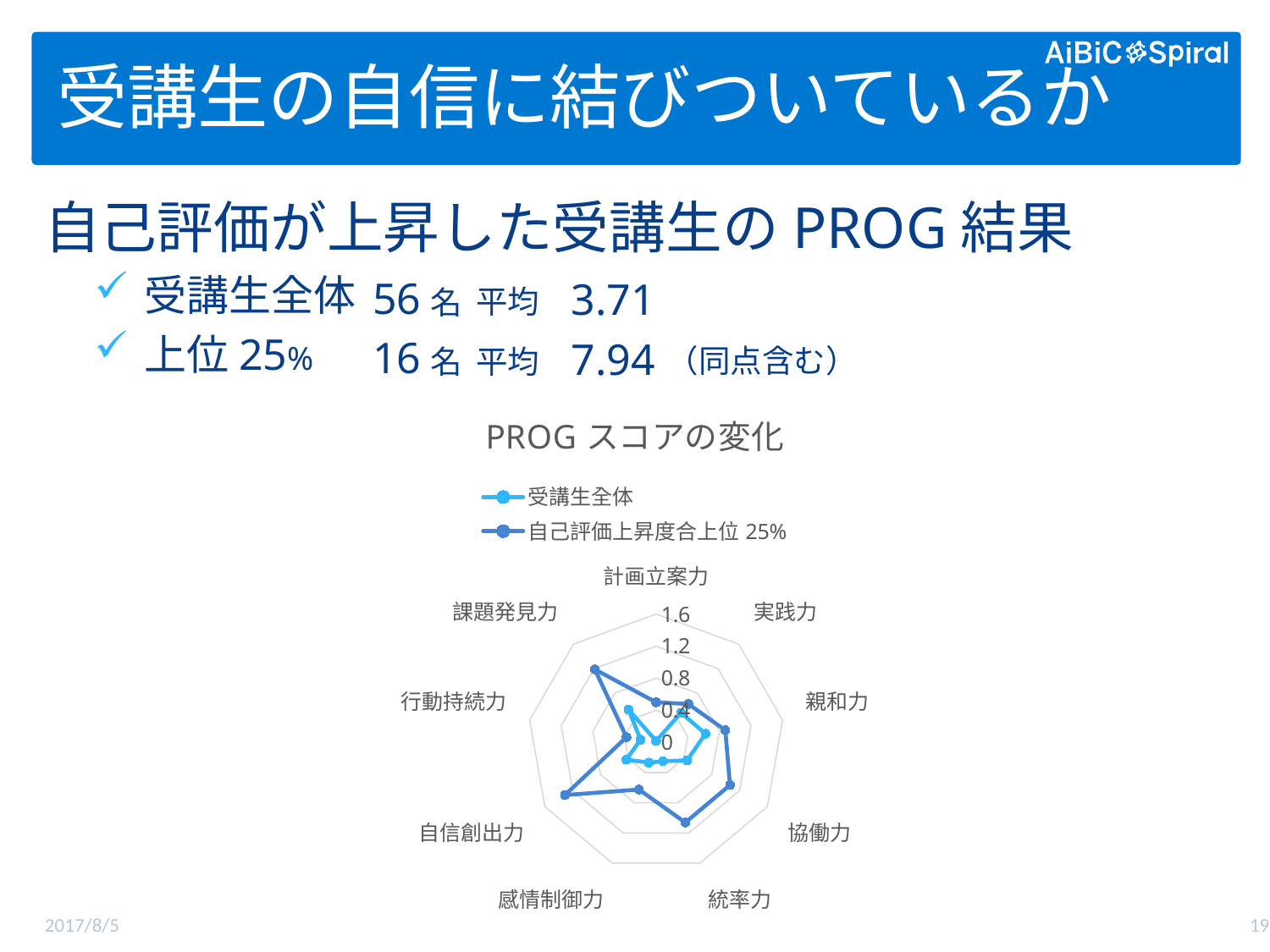
What kind of chart is shown on the slide? Radar chart Is the value for 統率力 in the 受講生全体 series greater or less than 0.8? less How many series does the chart legend list? 2 Which two series are listed in the chart legend? 受講生全体 and 自己評価上昇度合上位 25% Is the value for 自信創出力 in the 受講生全体 series greater or less than 0.8? less Is the value for 統率力 in the 自己評価上昇度合上位 25% series greater or less than 0.8? greater What is the title of the chart? PROG スコアの変化 In the 自己評価上昇度合上位 25% series, which category has the highest value? 自信創出力 In the 自己評価上昇度合上位 25% series, which is larger: 自信創出力 or 統率力? 自信創出力 How many categories (axes) does the radar chart have? 9 For 自信創出力, which series has the larger value: 受講生全体 or 自己評価上昇度合上位 25%? 自己評価上昇度合上位 25%